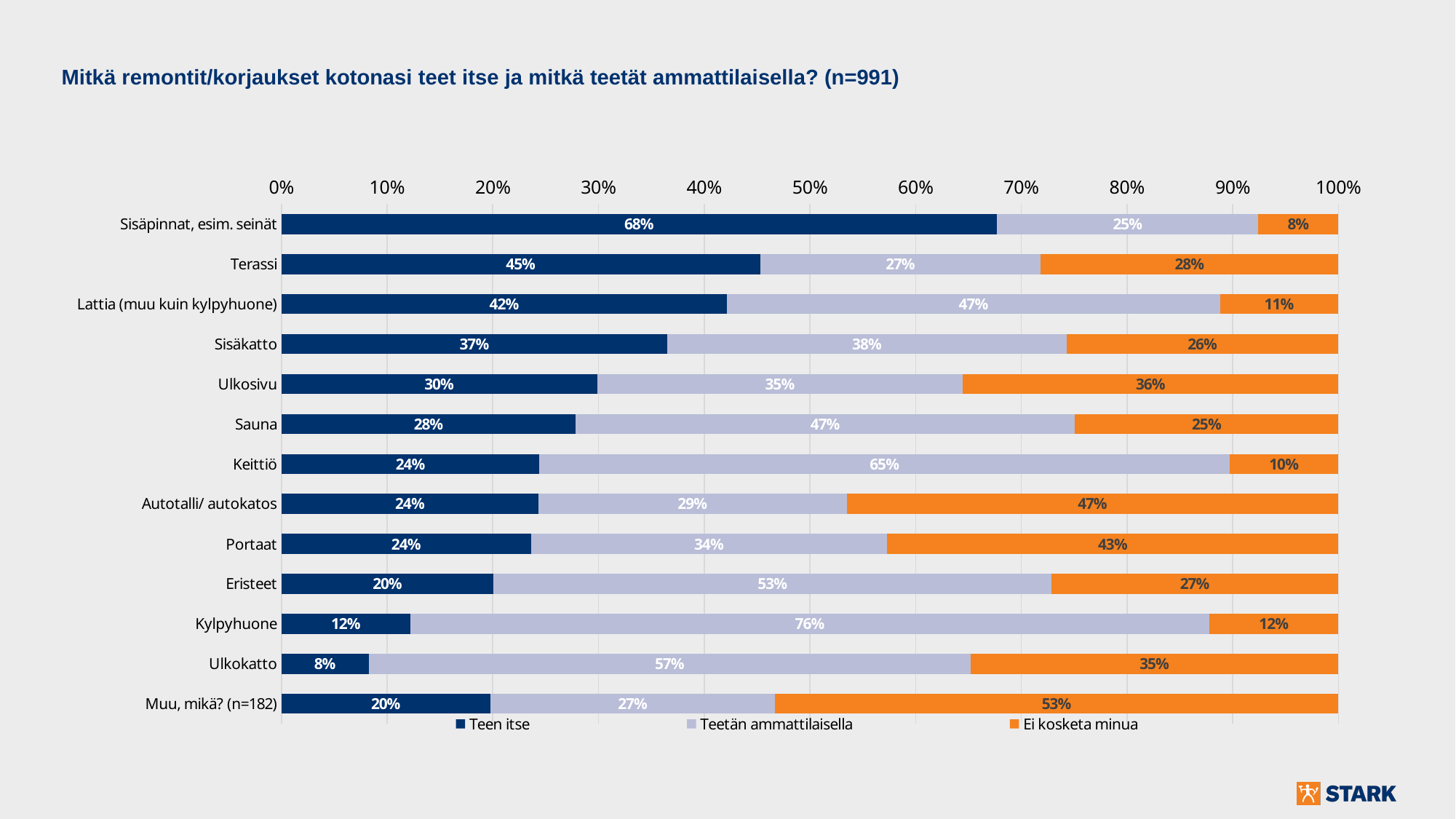
What is the "Ei kosketa minua" value for Autotalli/ autokatos? 47% What percentage of respondents answered "Teen itse" for Sisäpinnat, esim. seinät? 68% How many categories (renovation types) are shown on the chart? 13 What is the "Teetän ammattilaisella" value for Kylpyhuone? 76% Which category has the lowest "Teen itse" share? Ulkokatto For Kylpyhuone, how many percentage points larger is the "Teetän ammattilaisella" share than the "Teen itse" share? 64 percentage points Which is larger: the "Teetän ammattilaisella" share for Sauna or for Ulkosivu? Sauna Which series is shown in orange in the legend? Ei kosketa minua Which category has the highest "Teen itse" share? Sisäpinnat, esim. seinät How many series does the legend list? 3 What kind of chart is shown on the slide? Stacked bar chart Which category has the highest "Ei kosketa minua" share? Muu, mikä? (n=182)